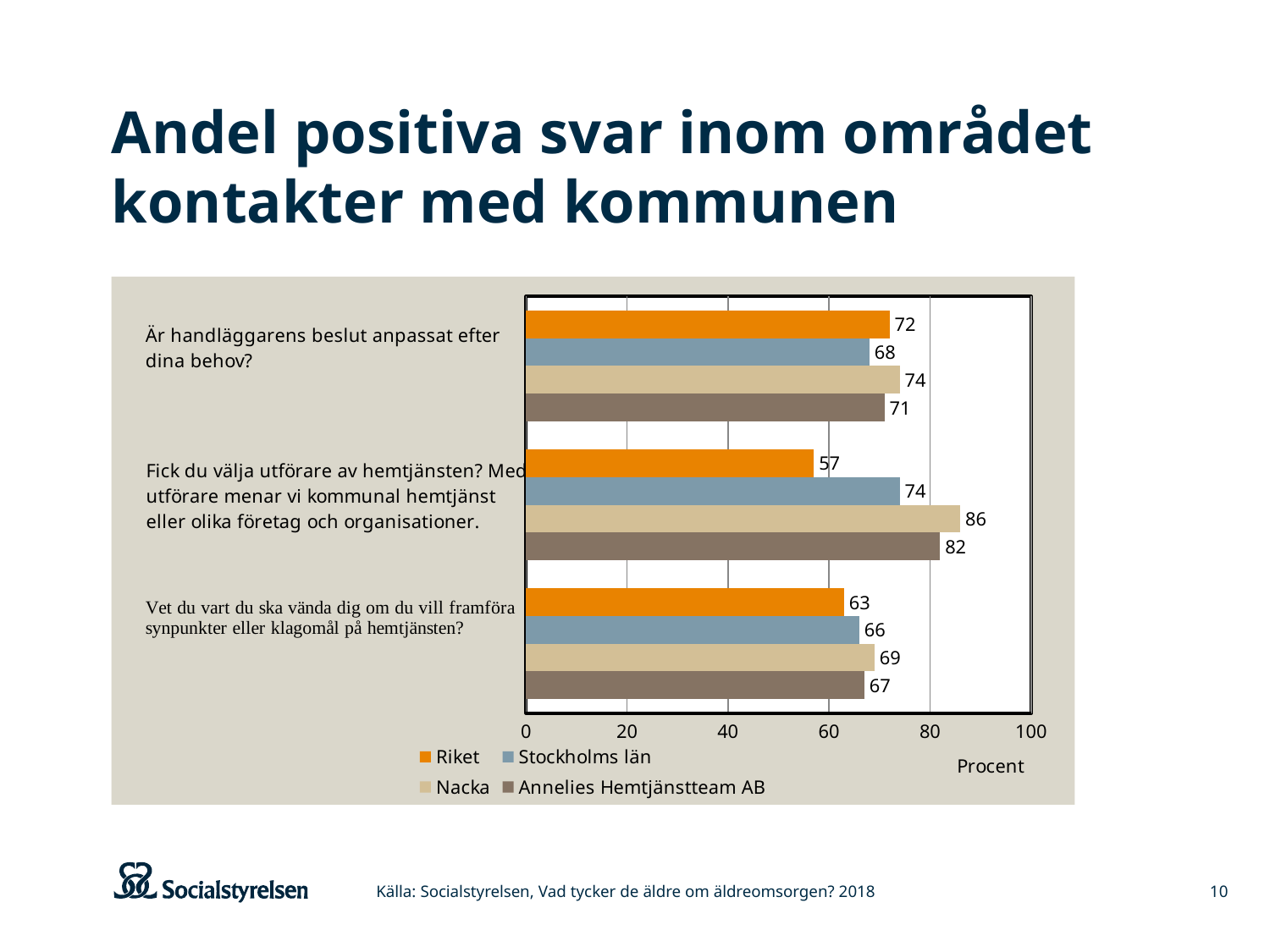
What kind of chart is shown on the slide? Bar chart Which series has the lowest value on the question "Är handläggarens beslut anpassat efter dina behov?" Stockholms län Which is larger on the question "Vet du vart du ska vända dig om du vill framföra synpunkter eller klagomål på hemtjänsten?": Riket or Nacka? Nacka How many questions (categories) are shown on the chart? 3 How many series does the legend list? 4 What is the value for Annelies Hemtjänstteam AB on the question "Vet du vart du ska vända dig om du vill framföra synpunkter eller klagomål på hemtjänsten?" 67 What is the difference between Nacka and Riket on the question "Fick du välja utförare av hemtjänsten?" 29 Which series has the highest value on the question "Fick du välja utförare av hemtjänsten?" Nacka What is the value for Nacka on the question "Fick du välja utförare av hemtjänsten?" 86 Is the value for Annelies Hemtjänstteam AB on the question "Fick du välja utförare av hemtjänsten?" greater or less than 80? greater What is the value for Stockholms län on the question "Fick du välja utförare av hemtjänsten?" 74 What is the value for Riket on the question "Är handläggarens beslut anpassat efter dina behov?" 72